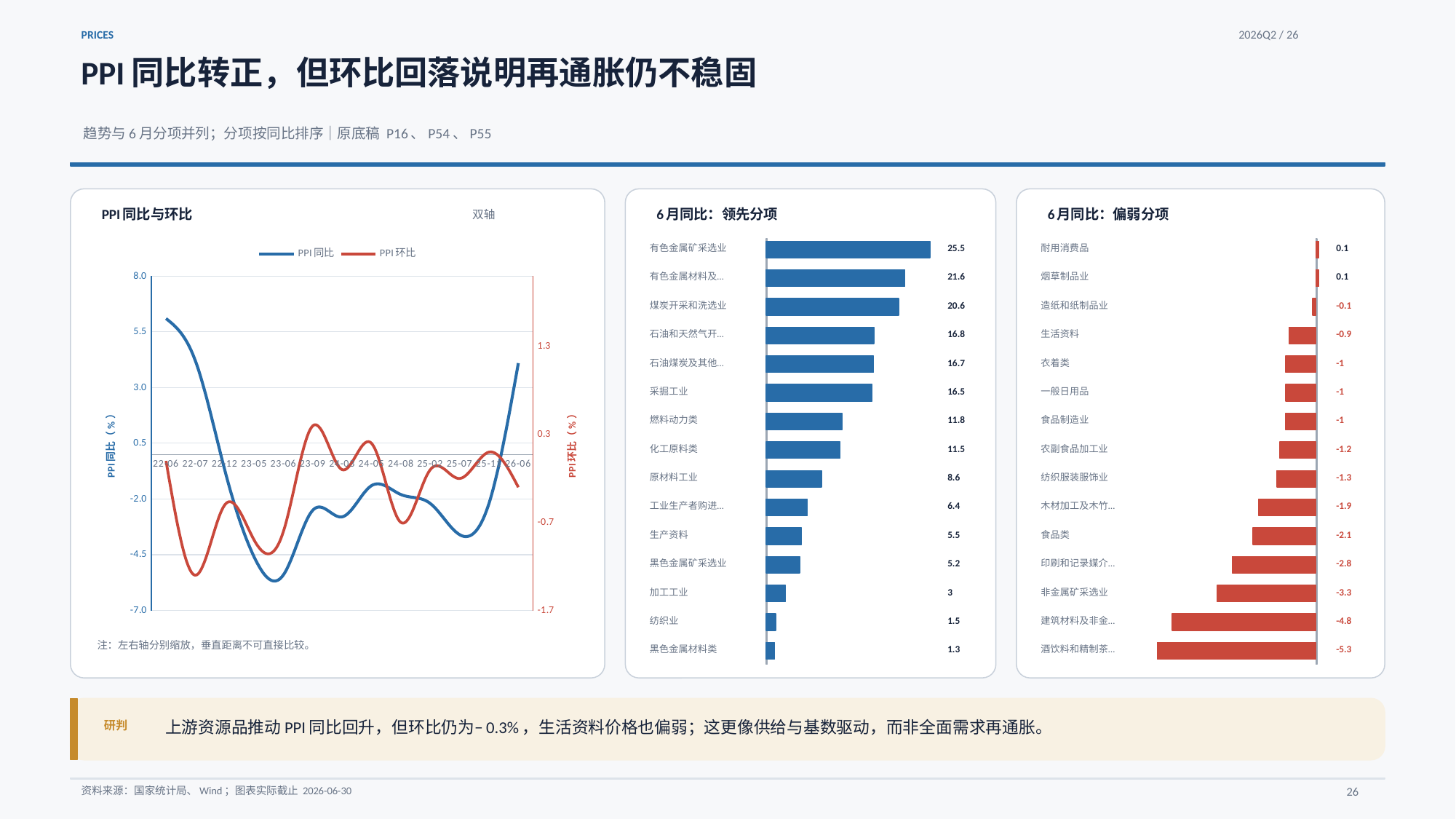
In the "6月同比：偏弱分项" chart, which is larger, the value for 食品类 or the value for 印刷和记录媒介...? 食品类 In the "6月同比：偏弱分项" chart, what is the difference between the values for 建筑材料及非金... and 酒饮料和精制茶...? 0.5 How many categories are shown in the "6月同比：领先分项" chart? 15 What kind of chart is the "6月同比：领先分项" chart? bar chart What kind of chart is the "PPI 同比与环比" chart on the left? line chart In the "6月同比：领先分项" chart, which category has the highest value? 有色金属矿采选业 How many series does the legend of the "PPI 同比与环比" chart list? 2 In the "6月同比：领先分项" chart, what is the value for 煤炭开采和洗选业? 20.6 In the "6月同比：领先分项" chart, what is the difference between the values for 燃料动力类 and 化工原料类? 0.3 In the "6月同比：偏弱分项" chart, what is the value for 非金属矿采选业? -3.3 In the "PPI 同比与环比" chart, is the PPI 同比 value at 22-06 greater or less than 3.0? greater In the "6月同比：偏弱分项" chart, which category has the lowest value? 酒饮料和精制茶...